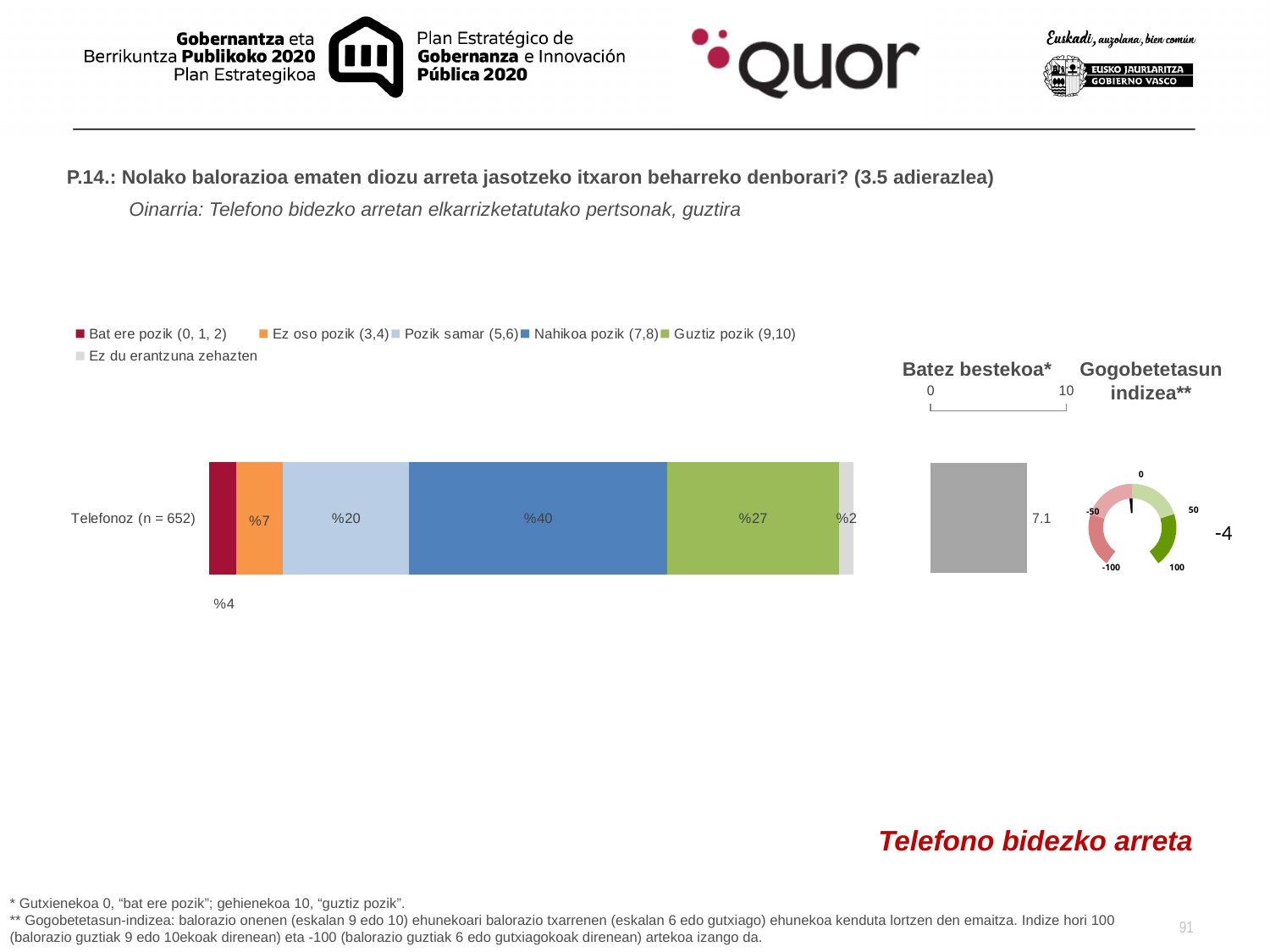
In the stacked bar chart, what is the value for 'Guztiz pozik (9,10)' for Telefonoz (n = 652)? %27 In the stacked bar chart, which series has the smallest share of the Telefonoz bar? Ez du erantzuna zehazten In the stacked bar chart, which is larger for Telefonoz: 'Pozik samar (5,6)' or 'Ez oso pozik (3,4)'? Pozik samar (5,6) In the 'Gogobetetasun indizea**' gauge, what value is shown? -4 In the stacked bar chart, what is the difference between the 'Nahikoa pozik (7,8)' and 'Guztiz pozik (9,10)' values for Telefonoz? %13 How many series does the legend of the stacked bar chart list? 6 In the stacked bar chart, what is the value for 'Ez oso pozik (3,4)' for Telefonoz (n = 652)? %7 In the stacked bar chart, what is the value for 'Bat ere pozik (0, 1, 2)' for Telefonoz (n = 652)? %4 In the 'Batez bestekoa*' chart, what is the value shown for Telefonoz? 7.1 In the stacked bar chart, which series has the largest share of the Telefonoz bar? Nahikoa pozik (7,8) In the stacked bar chart, what is the value for 'Nahikoa pozik (7,8)' for Telefonoz (n = 652)? %40 In the stacked bar chart, what is the value for 'Pozik samar (5,6)' for Telefonoz (n = 652)? %20